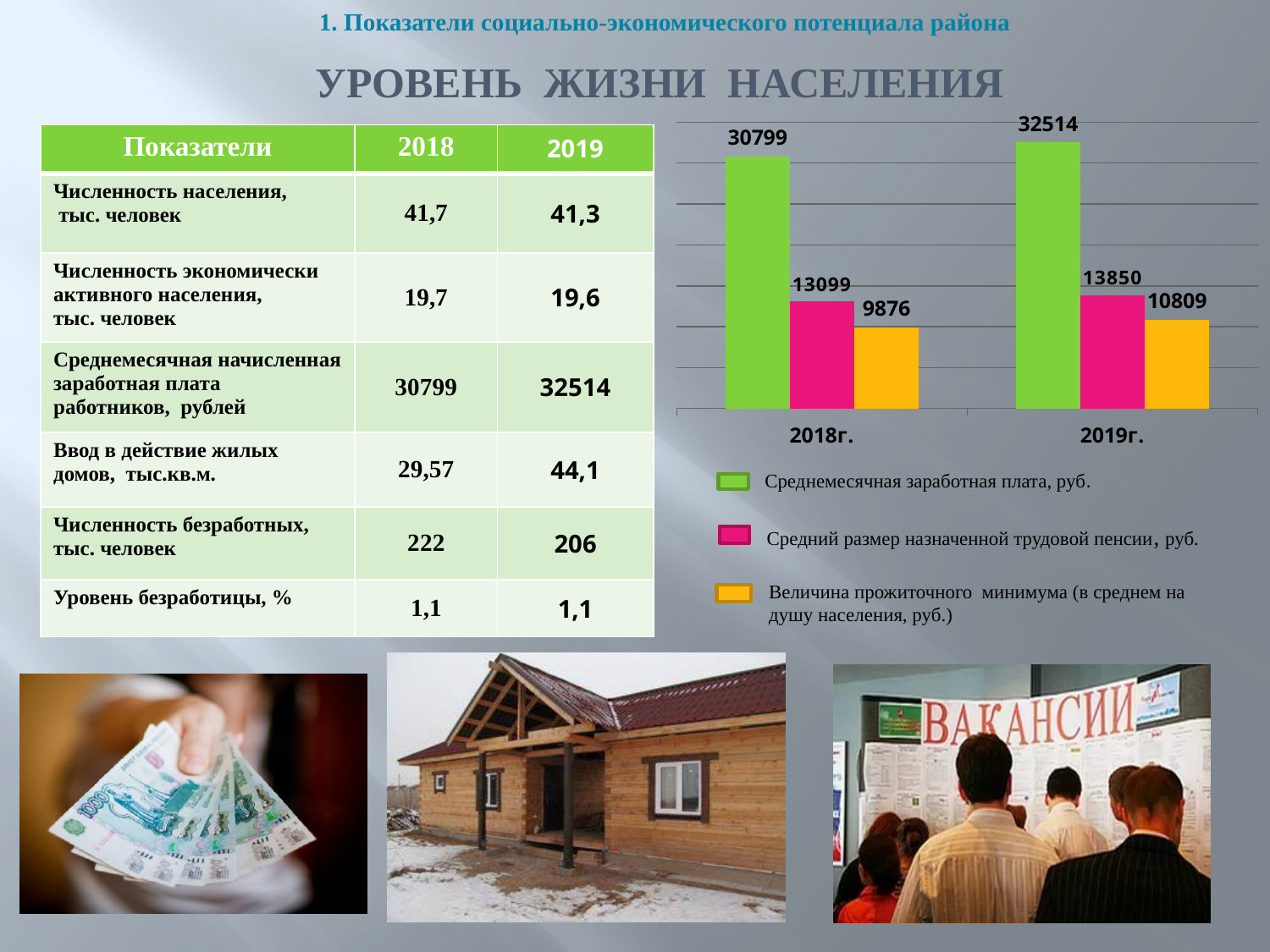
What is the subsistence minimum (Величина прожиточного минимума) for 2019г.? 10809 How many year categories are shown on the x axis of the chart? 2 Which series has the lowest value in 2018г.? Величина прожиточного минимума (в среднем на душу населения, руб.) What is the difference between the average pension and the subsistence minimum in 2019г.? 3041 By how much did the average monthly salary increase from 2018г. to 2019г.? 1715 How many series does the chart legend list? 3 What is the average monthly salary (Среднемесячная заработная плата) shown for 2019г.? 32514 Which year has the higher subsistence minimum, 2018г. or 2019г.? 2019г. Does the average pension rise or fall from 2018г. to 2019г.? rise What is the average monthly salary (Среднемесячная заработная плата) shown for 2018г.? 30799 What type of chart is shown on the slide? bar chart What is the average assigned pension (Средний размер назначенной трудовой пенсии) for 2018г.? 13099